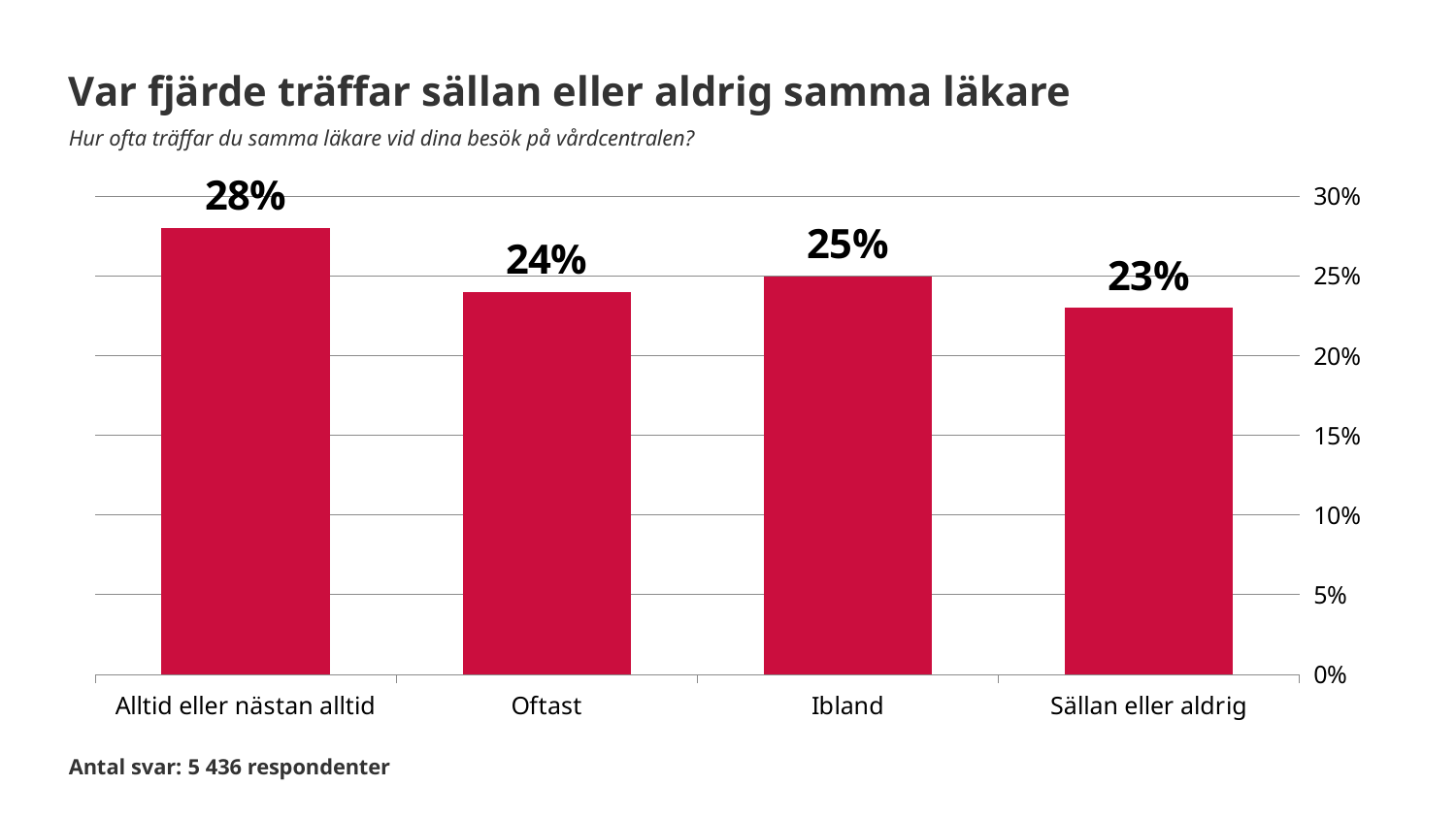
Which category has the lowest value? Sällan eller aldrig What is the value for "Oftast"? 24% What kind of chart is shown on the slide? Bar chart What is the value for "Sällan eller aldrig"? 23% What is the value for "Ibland"? 25% Which category has the highest value? Alltid eller nästan alltid How many categories are shown on the x axis? 4 What is the title of the slide? Var fjärde träffar sällan eller aldrig samma läkare Is the value for "Alltid eller nästan alltid" greater or less than 25%? greater What is the difference between the values for "Alltid eller nästan alltid" and "Sällan eller aldrig"? 5% What is the value for "Alltid eller nästan alltid"? 28% Which is larger, the value for "Ibland" or the value for "Oftast"? Ibland